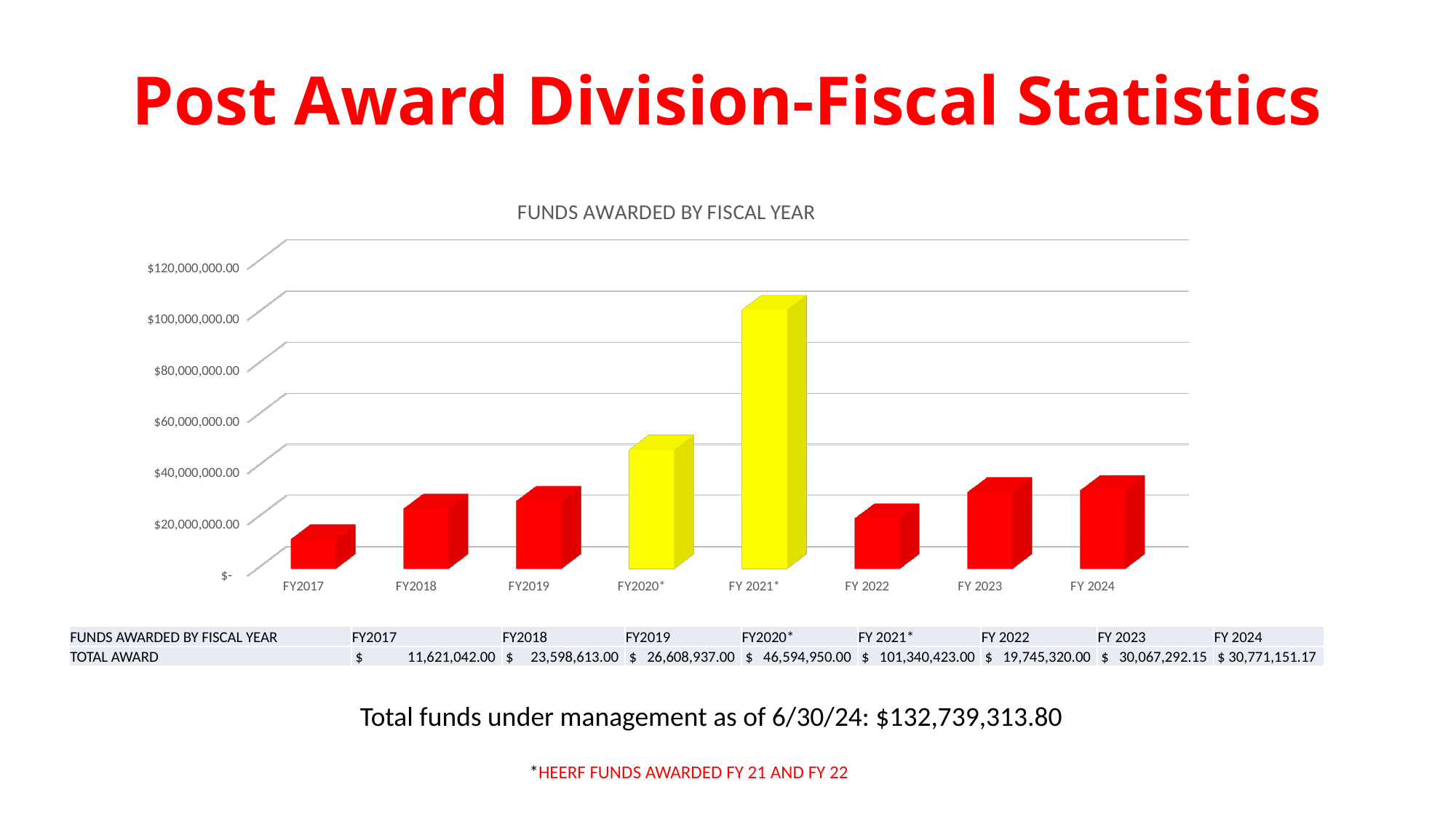
Which fiscal year has the lowest total award? FY2017 What is the title of the chart? FUNDS AWARDED BY FISCAL YEAR What kind of chart is shown on the slide? bar chart What is the total award for FY2017? $11,621,042.00 How many fiscal years are shown in the chart? 8 Which fiscal year has the highest total award? FY 2021* Do the total awards rise or fall from FY2017 to FY2019? rise What is the total award for FY 2021*? $101,340,423.00 What is the difference between the total award for FY 2021* and FY2020*? $54,745,473.00 What is the total award for FY 2024? $30,771,151.17 Which has a larger total award, FY2020* or FY 2022? FY2020* Is the value for FY2020* greater or less than $40,000,000.00? greater